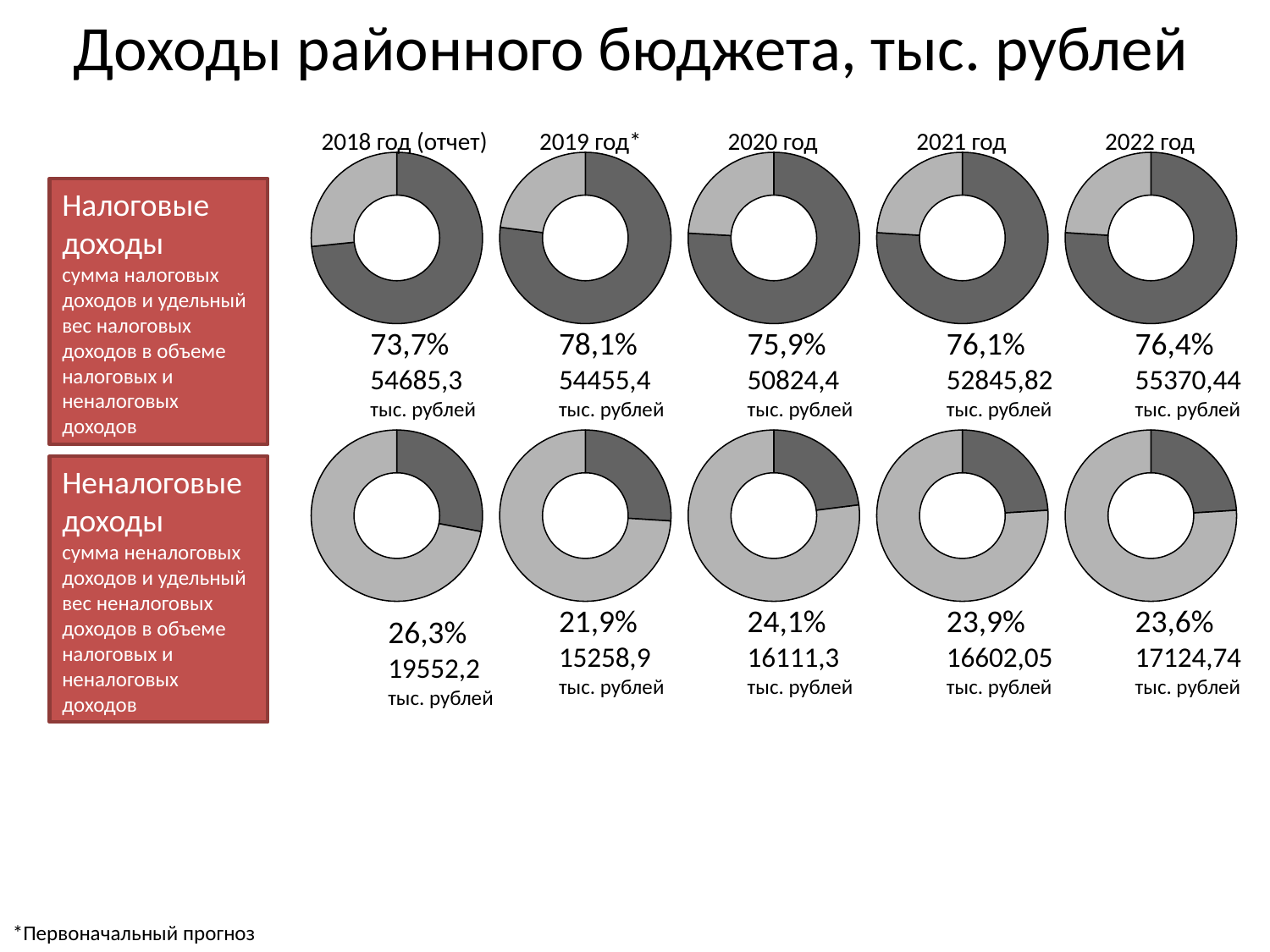
What type of chart is used on the slide to show the shares of tax and non-tax revenues? Donut (pie) chart How many donut charts are shown on the slide in total? 10 Across the bottom row of donut charts (Неналоговые доходы), which year has the highest share of non-tax revenues? 2018 год (отчет) In the top row of donut charts (Налоговые доходы), what is the amount of tax revenues for 2022 год? 55370,44 тыс. рублей Across the top row of donut charts (Налоговые доходы), which year has the highest share of tax revenues? 2019 год In the bottom row of donut charts (Неналоговые доходы), what share do non-tax revenues make up in 2021 год? 23,9% In the top row of donut charts (Налоговые доходы), what share of revenues do tax revenues make up in 2018 год (отчет)? 73,7% In the bottom row of donut charts (Неналоговые доходы), what is the amount of non-tax revenues for 2019 год? 15258,9 тыс. рублей In the top row of donut charts (Налоговые доходы), what is the difference between the tax revenue amounts for 2022 год and 2021 год? 2524,62 тыс. рублей In the bottom row of donut charts (Неналоговые доходы), do the non-tax revenue amounts rise or fall from 2019 год to 2022 год? Rise In the top row of donut charts (Налоговые доходы), which is larger: the tax revenue amount for 2018 год (отчет) or for 2019 год? 2018 год (отчет) Across the top row of donut charts (Налоговые доходы), which year has the lowest amount of tax revenues? 2020 год